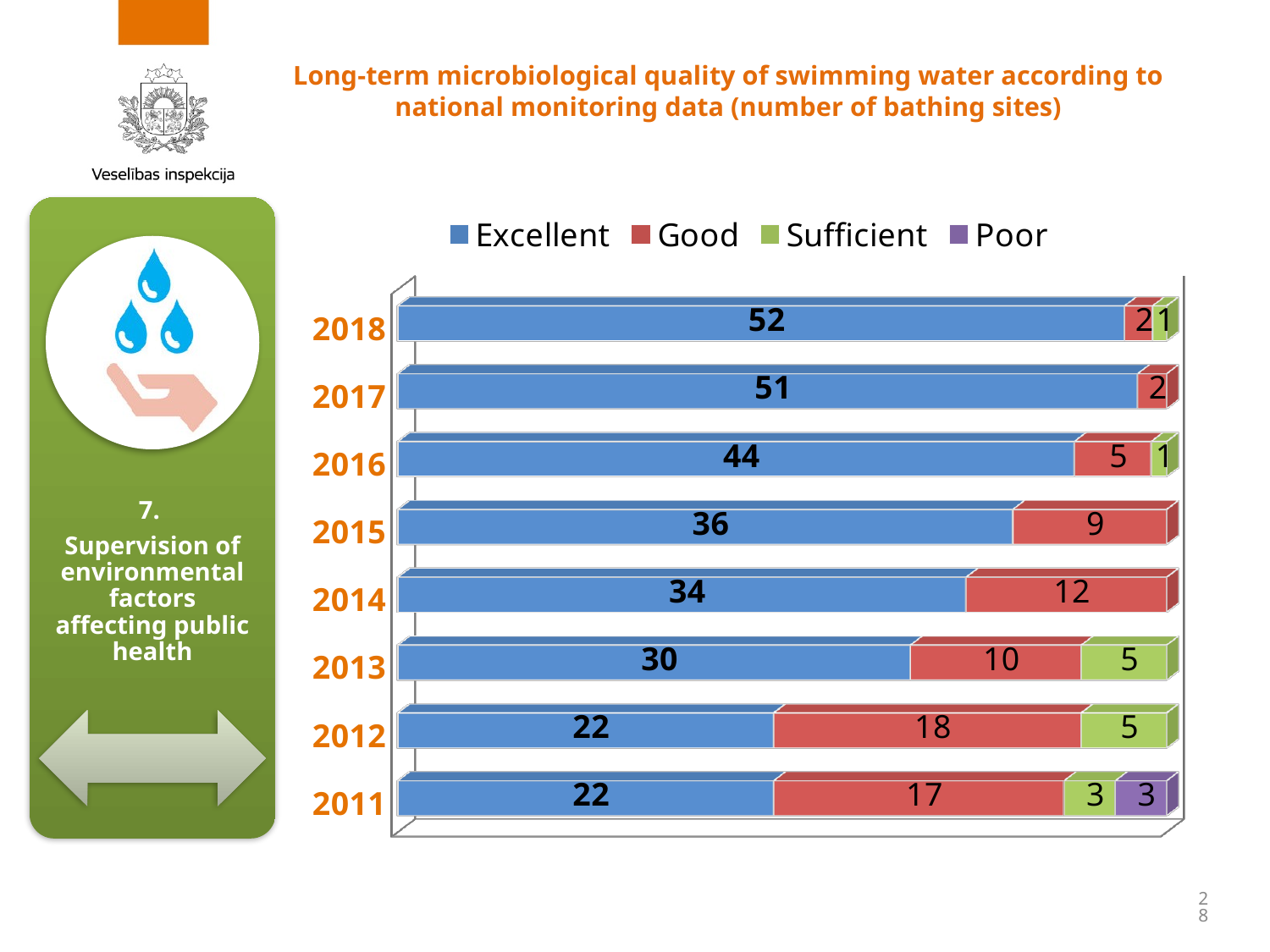
What is the number of bathing sites with Good quality in 2012? 18 Which year has the highest number of bathing sites with Good quality? 2012 What is the number of bathing sites with Poor quality in 2011? 3 How many years are shown on the chart? 8 Which is larger, the Good value for 2014 or the Good value for 2013? 2014 How many series does the legend list? 4 What is the number of bathing sites with Excellent quality in 2018? 52 Which year has the highest number of bathing sites with Excellent quality? 2018 Does the Excellent value generally rise or fall from 2011 to 2018? Rise What kind of chart is shown on the slide? Stacked bar chart What is the difference between the Excellent values for 2018 and 2011? 30 What is the total number of bathing sites shown for 2011? 45